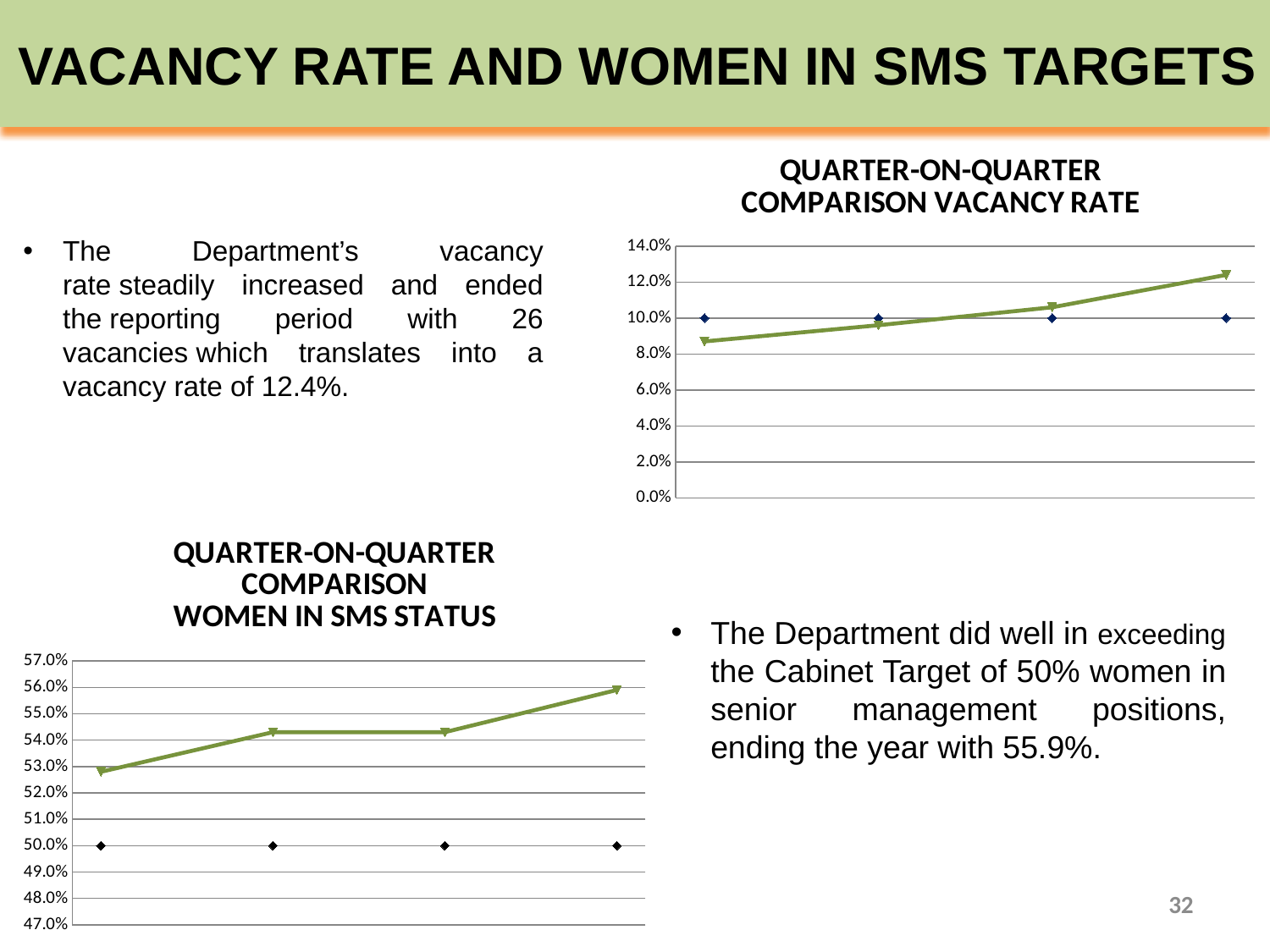
In the QUARTER-ON-QUARTER COMPARISON VACANCY RATE chart, what constant value does the flat blue diamond line sit at? 10.0% In the QUARTER-ON-QUARTER COMPARISON WOMEN IN SMS STATUS chart, how many data points does the green line have? 4 In the QUARTER-ON-QUARTER COMPARISON WOMEN IN SMS STATUS chart, does the green line rise or fall from left to right? rise In the QUARTER-ON-QUARTER COMPARISON VACANCY RATE chart, is the last point of the green line greater or less than 12.0%? greater In the QUARTER-ON-QUARTER COMPARISON VACANCY RATE chart, what kind of chart is shown? line chart In the QUARTER-ON-QUARTER COMPARISON WOMEN IN SMS STATUS chart, which is higher on the green line, the first point or the last point? the last point In the QUARTER-ON-QUARTER COMPARISON VACANCY RATE chart, does the green line rise or fall from left to right? rise In the QUARTER-ON-QUARTER COMPARISON WOMEN IN SMS STATUS chart, what constant value does the flat blue diamond line sit at? 50.0% In the QUARTER-ON-QUARTER COMPARISON VACANCY RATE chart, is the first point of the green line greater or less than 10.0%? less In the QUARTER-ON-QUARTER COMPARISON WOMEN IN SMS STATUS chart, is the first point of the green line greater or less than 54.0%? less In the QUARTER-ON-QUARTER COMPARISON WOMEN IN SMS STATUS chart, what kind of chart is shown? line chart In the QUARTER-ON-QUARTER COMPARISON VACANCY RATE chart, how many data points does the green line have? 4